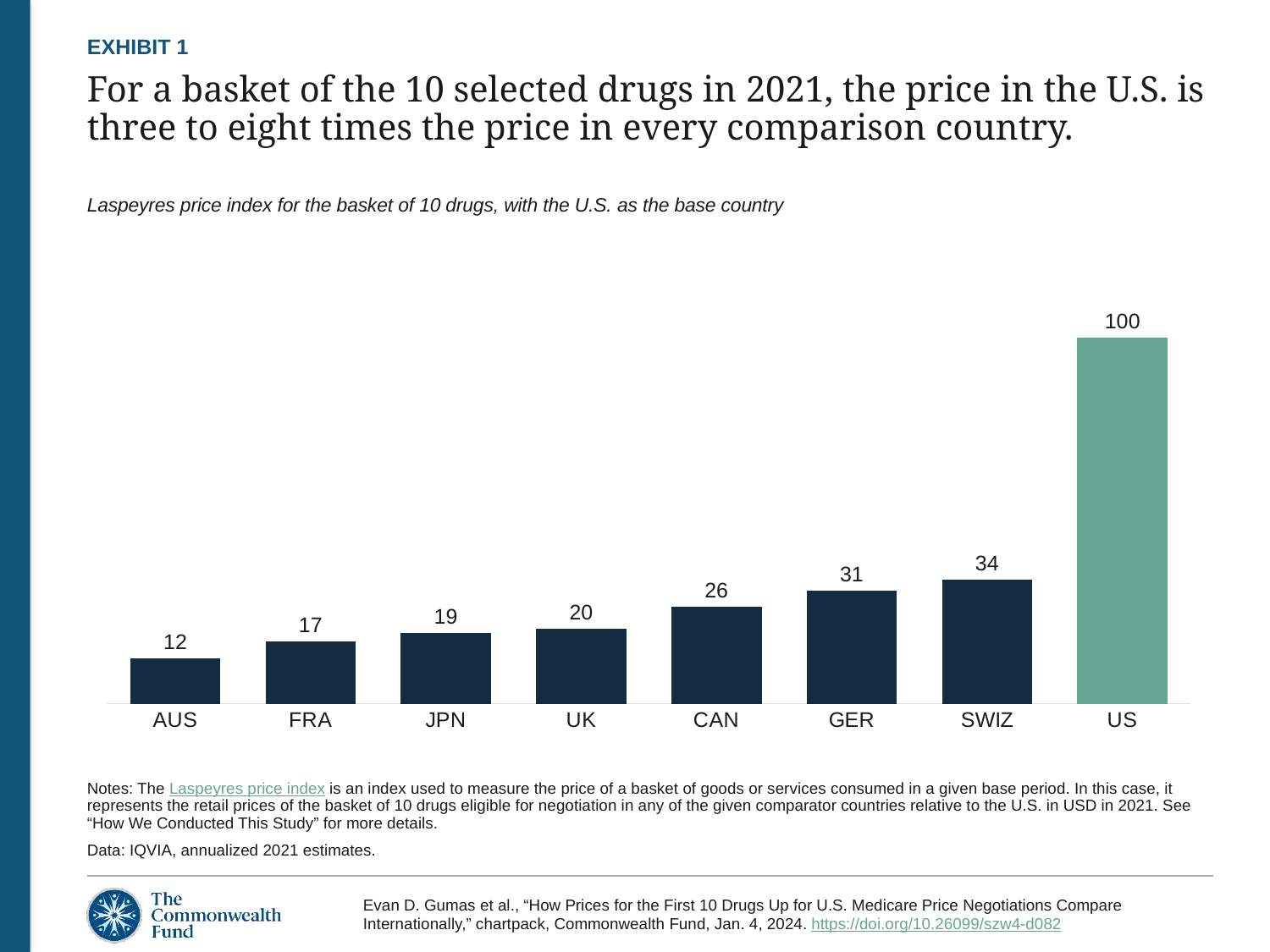
Which has a higher value, Japan (JPN) or the UK? UK How many countries are shown on the chart? 8 What is the value shown for Australia (AUS)? 12 What is the difference between the values for the US and Switzerland (SWIZ)? 66 Do the values rise or fall moving from left to right across the chart? Rise What is the value shown for Switzerland (SWIZ)? 34 What type of chart is shown on the slide? Bar chart Which country has the highest value on the chart? US Which bar is shown in a different colour from the others? US What is the Laspeyres price index value for Canada (CAN)? 26 Which country has the lowest value on the chart? AUS What is the difference between the values for Germany (GER) and France (FRA)? 14